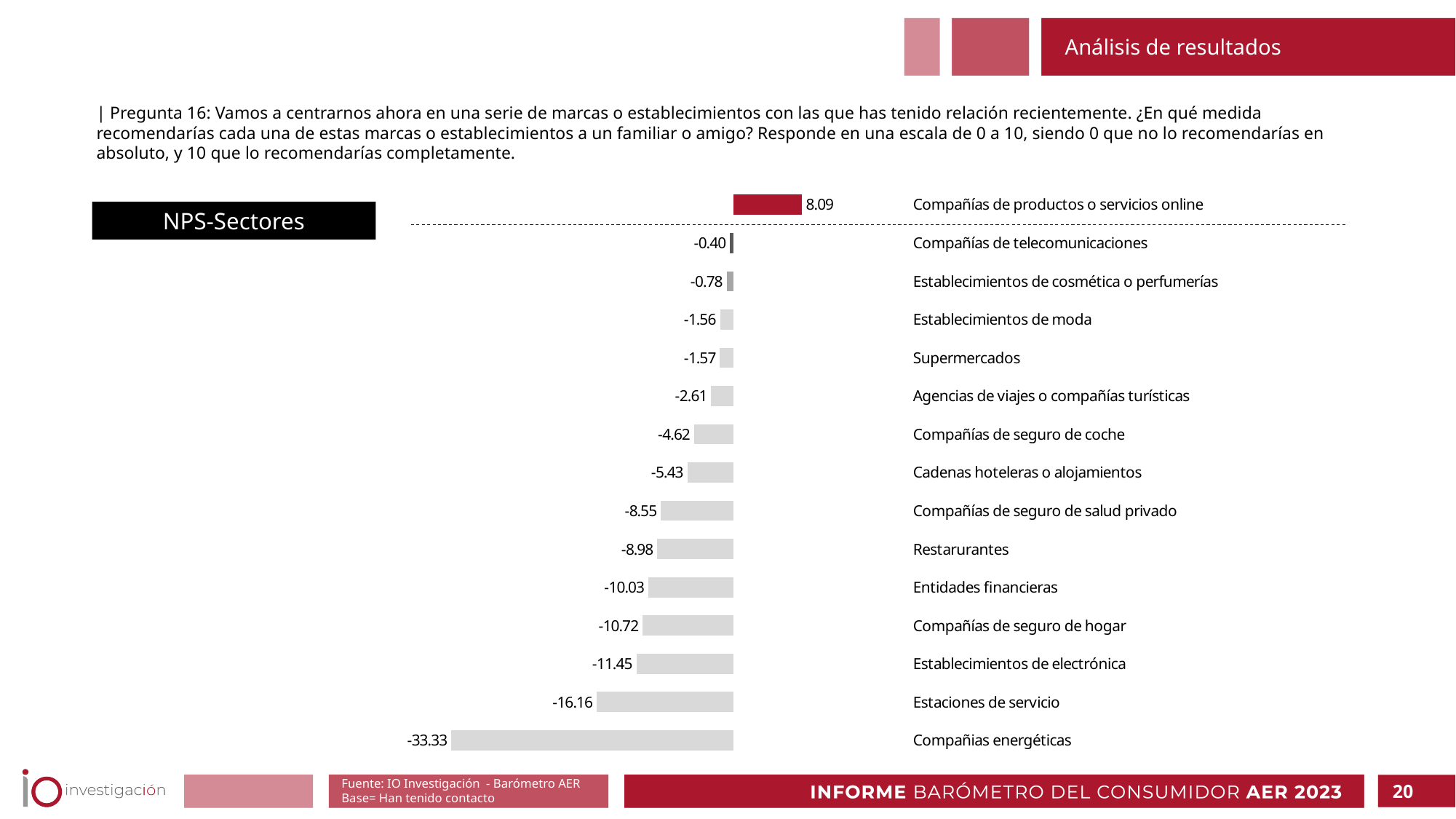
What is the NPS value for Compañias energéticas? -33.33 What is the difference between the NPS values for Compañías de productos o servicios online and Compañías de telecomunicaciones? 8.49 Which sector has the highest NPS value? Compañías de productos o servicios online What is the NPS value for Entidades financieras? -10.03 What kind of chart is the NPS-Sectores chart? Bar chart What is the NPS value for Estaciones de servicio? -16.16 What is the NPS value for Compañías de productos o servicios online? 8.09 How many sectors are shown in the NPS-Sectores chart? 15 What is the NPS value for Supermercados? -1.57 Which sector has the lowest NPS value? Compañias energéticas Which has a higher NPS value, Cadenas hoteleras o alojamientos or Compañías de seguro de salud privado? Cadenas hoteleras o alojamientos Which sector's bar is shown in red rather than grey? Compañías de productos o servicios online